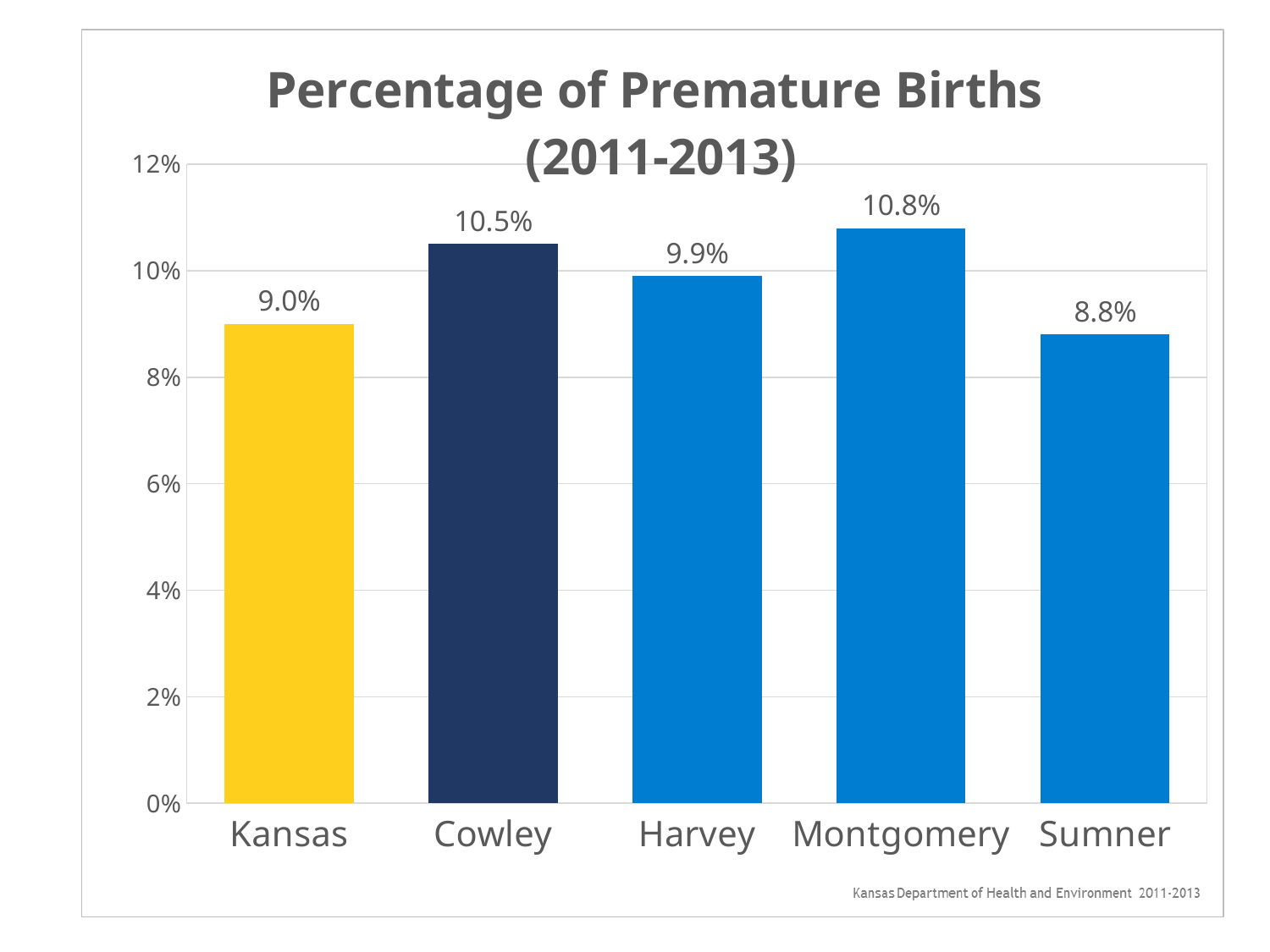
What is the title of the chart? Percentage of Premature Births (2011-2013) How many categories are shown on the x axis? 5 What is the percentage of premature births for Sumner? 8.8% What is the percentage of premature births for Cowley? 10.5% Which category has the lowest percentage of premature births? Sumner What is the difference in percentage points between Montgomery and Kansas? 1.8 What kind of chart is shown on the slide? bar chart Which has a higher percentage of premature births, Harvey or Cowley? Cowley Is the value for Harvey greater or less than 8%? greater Which category has the highest percentage of premature births? Montgomery Which bar is coloured yellow? Kansas What is the percentage of premature births for Kansas? 9.0%